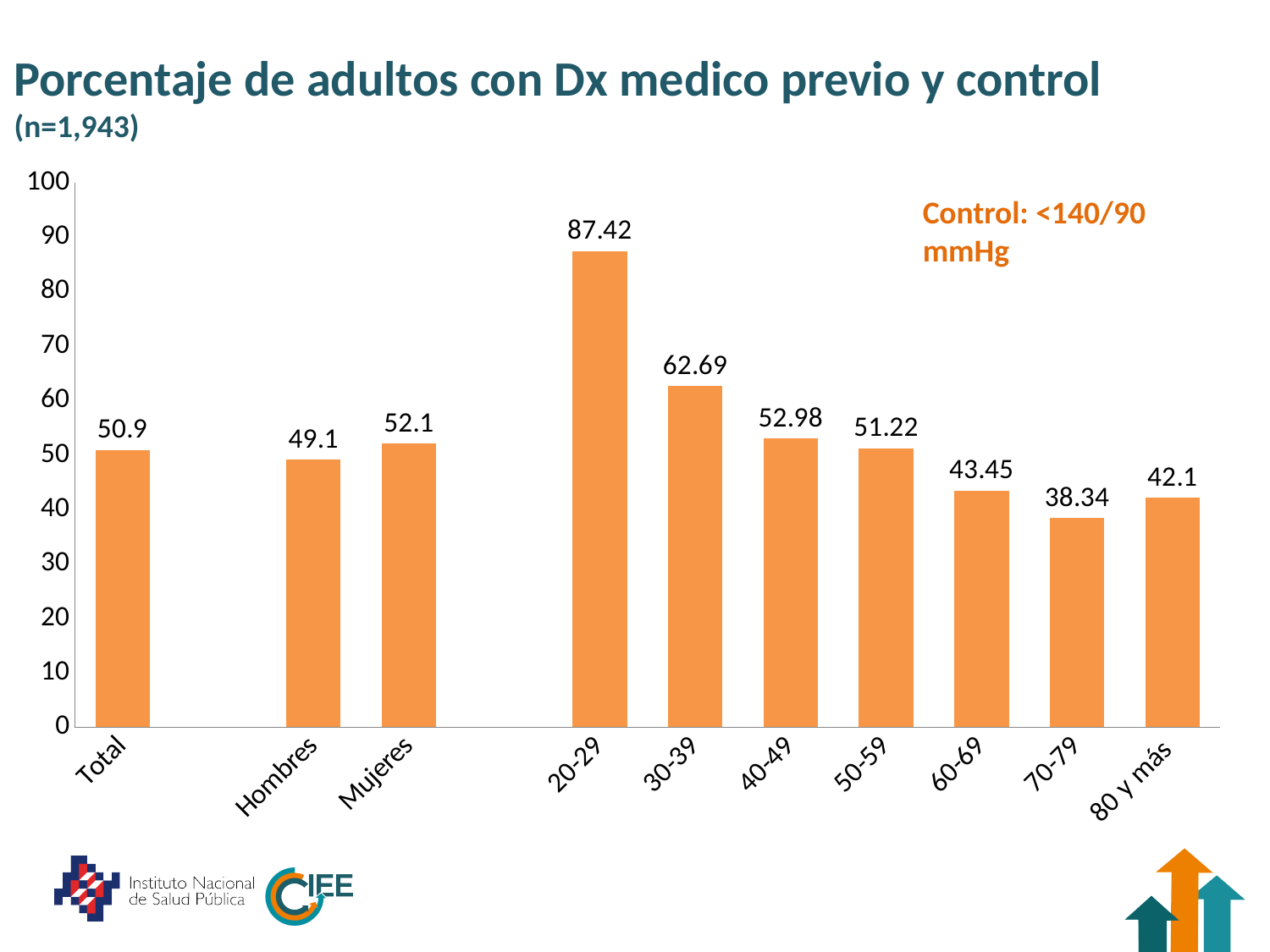
Is the value for 30-39 greater or less than 60? greater What is the sample size (n) stated under the chart title? 1,943 What is the difference between the values for Mujeres and Hombres? 3 What is the value for the 20-29 age group? 87.42 Which is larger, the value for 40-49 or the value for 60-69? 40-49 What kind of chart is shown on the slide? bar chart Which category has the highest value? 20-29 What is the value for Total? 50.9 What is the value for Mujeres? 52.1 Which category has the lowest value? 70-79 How many categories are shown on the x axis? 10 What is the difference between the values for 20-29 and 30-39? 24.73